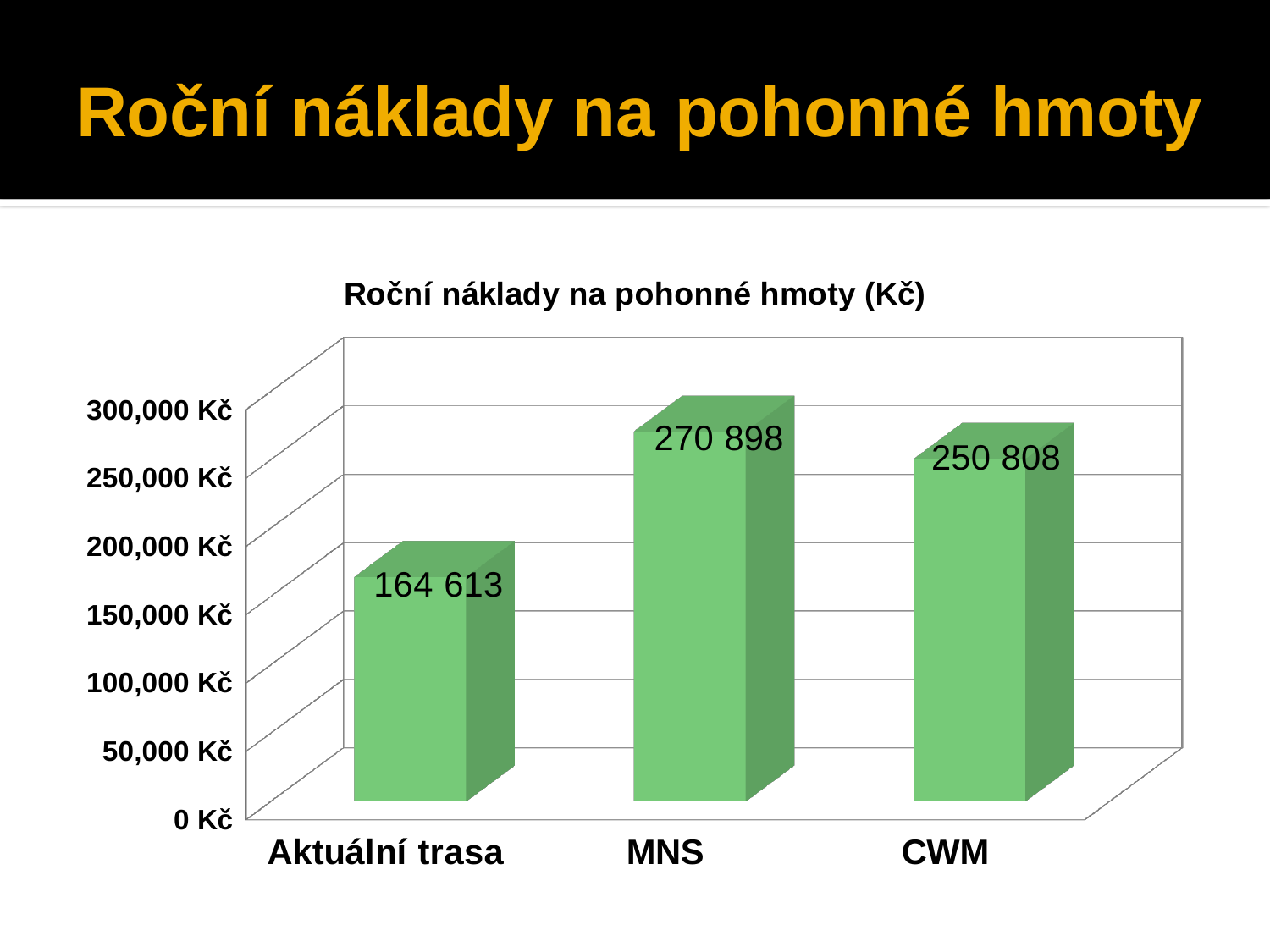
Is the value for MNS greater or less than 300,000 Kč? less Which category has the highest annual fuel cost? MNS What is the value for Aktuální trasa? 164 613 What is the value for CWM? 250 808 What is the value for MNS? 270 898 What is the title of the chart? Roční náklady na pohonné hmoty (Kč) Which is larger, the value for CWM or the value for Aktuální trasa? CWM What is the difference between the values for MNS and Aktuální trasa? 106 285 What kind of chart is shown on the slide? bar chart Which category has the lowest annual fuel cost? Aktuální trasa What is the difference between the values for MNS and CWM? 20 090 How many categories are shown on the x axis? 3